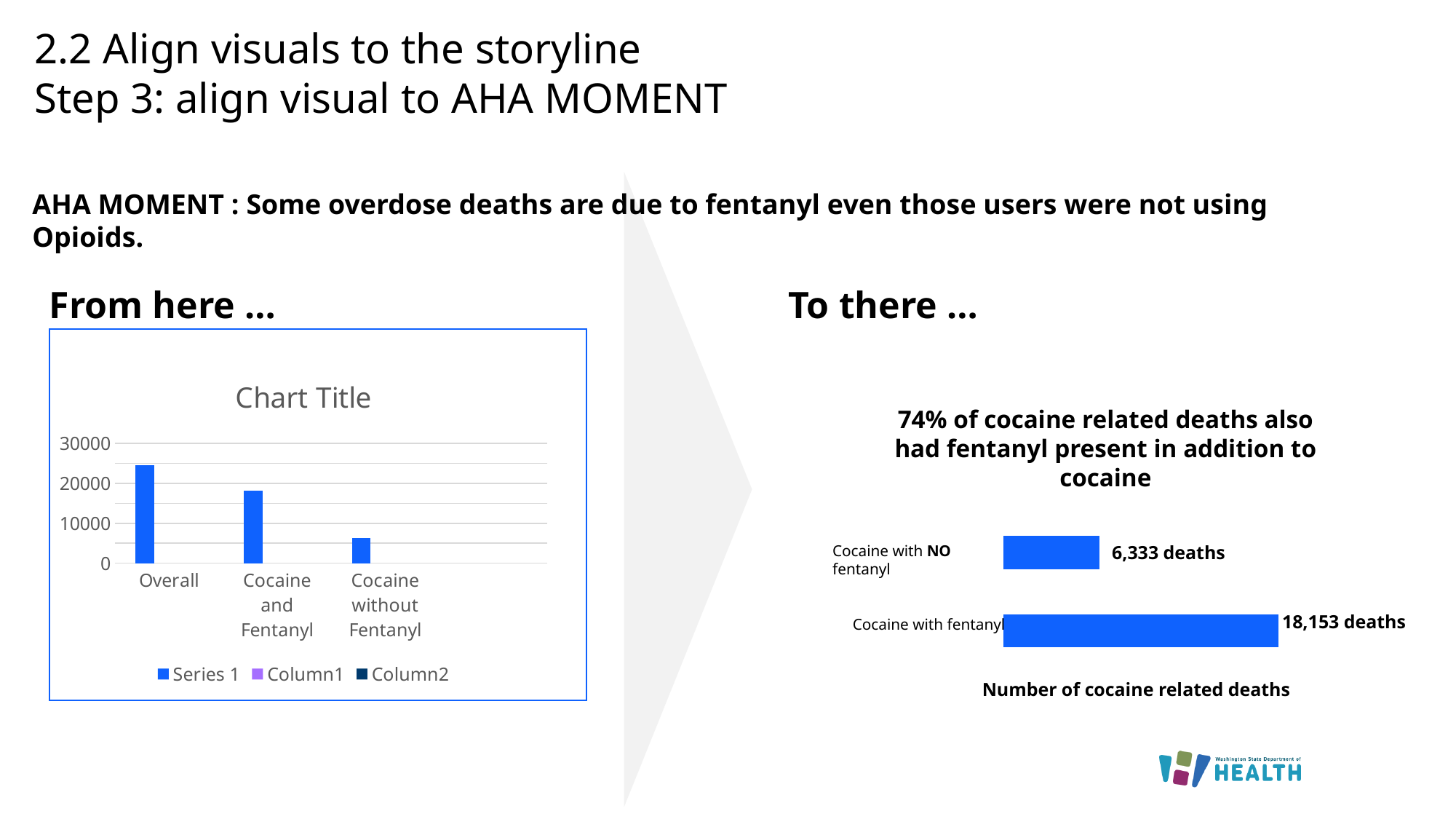
In the right chart, what is the axis label printed below the bars? Number of cocaine related deaths In the right chart, what is the difference in deaths between Cocaine with fentanyl and Cocaine with NO fentanyl? 11,820 deaths In the left chart titled "Chart Title", which category has the lowest value? Cocaine without Fentanyl In the left chart titled "Chart Title", is the value for Cocaine without Fentanyl greater or less than 10000? less In the left chart titled "Chart Title", how many categories are shown on the x axis? 3 In the right chart, how many deaths are shown for Cocaine with NO fentanyl? 6,333 deaths In the left chart titled "Chart Title", do the values rise or fall from left to right along the x axis? Fall In the left chart titled "Chart Title", what kind of chart is it? Bar chart In the left chart titled "Chart Title", which category has the highest value? Overall In the left chart titled "Chart Title", how many series does the legend list? 3 In the left chart titled "Chart Title", is the value for Overall greater or less than 20000? greater In the right chart, how many deaths are shown for Cocaine with fentanyl? 18,153 deaths